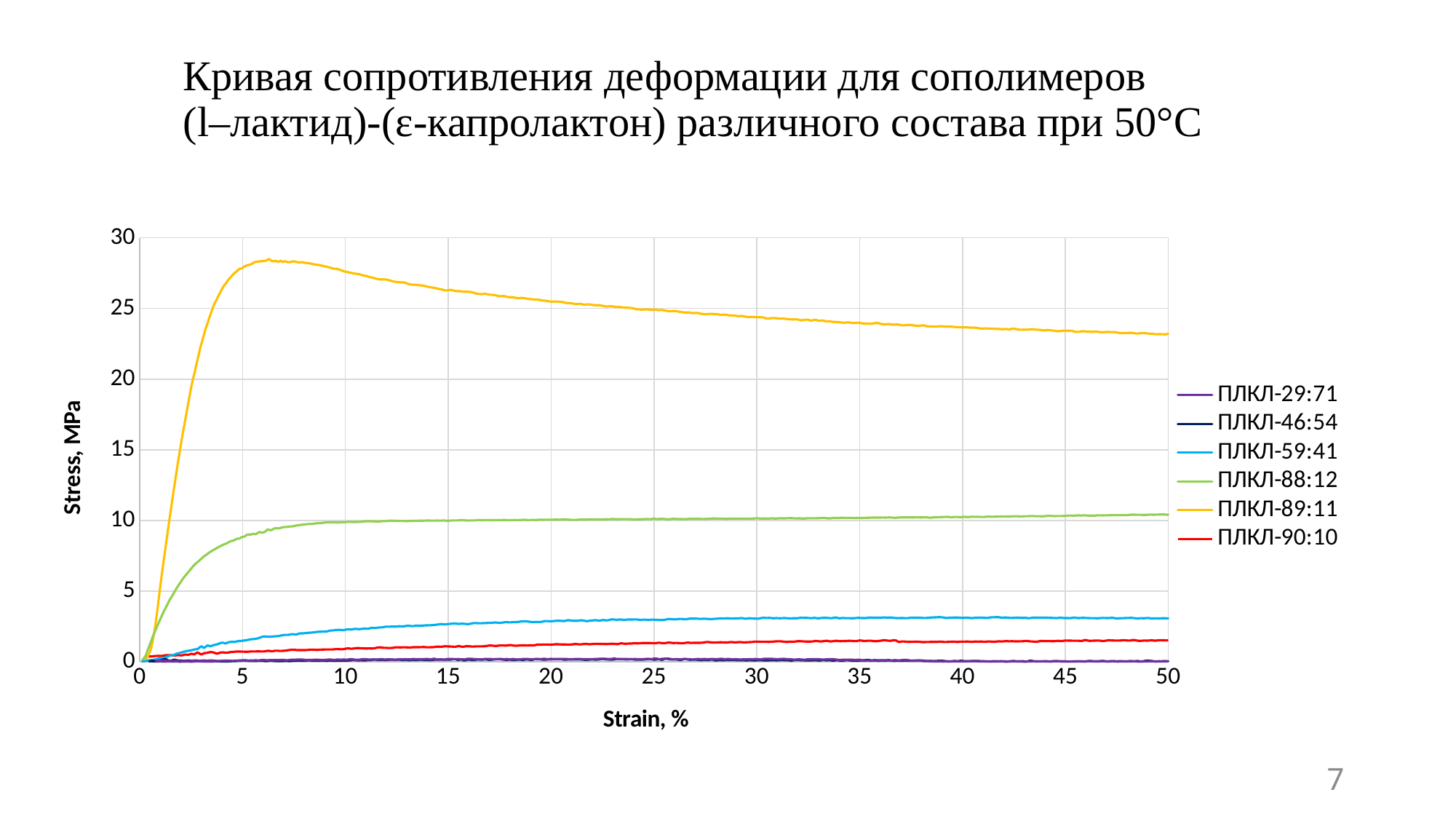
Is the stress for ПЛКЛ-90:10 at 50% strain greater or less than 5 MPa? less Is the peak stress for ПЛКЛ-89:11 greater or less than 25 MPa? greater What is the label of the horizontal axis? Strain, % How many series does the legend list? 6 Is the stress for ПЛКЛ-88:12 at 30% strain greater or less than 5 MPa? greater At 20% strain, which series has the higher stress: ПЛКЛ-88:12 or ПЛКЛ-59:41? ПЛКЛ-88:12 What is the label of the vertical axis? Stress, MPa Which series reaches the highest stress value on the chart? ПЛКЛ-89:11 After its peak near 5–7% strain, does the stress for ПЛКЛ-89:11 rise or fall as strain increases to 50%? fall What kind of chart is shown on the slide? line chart